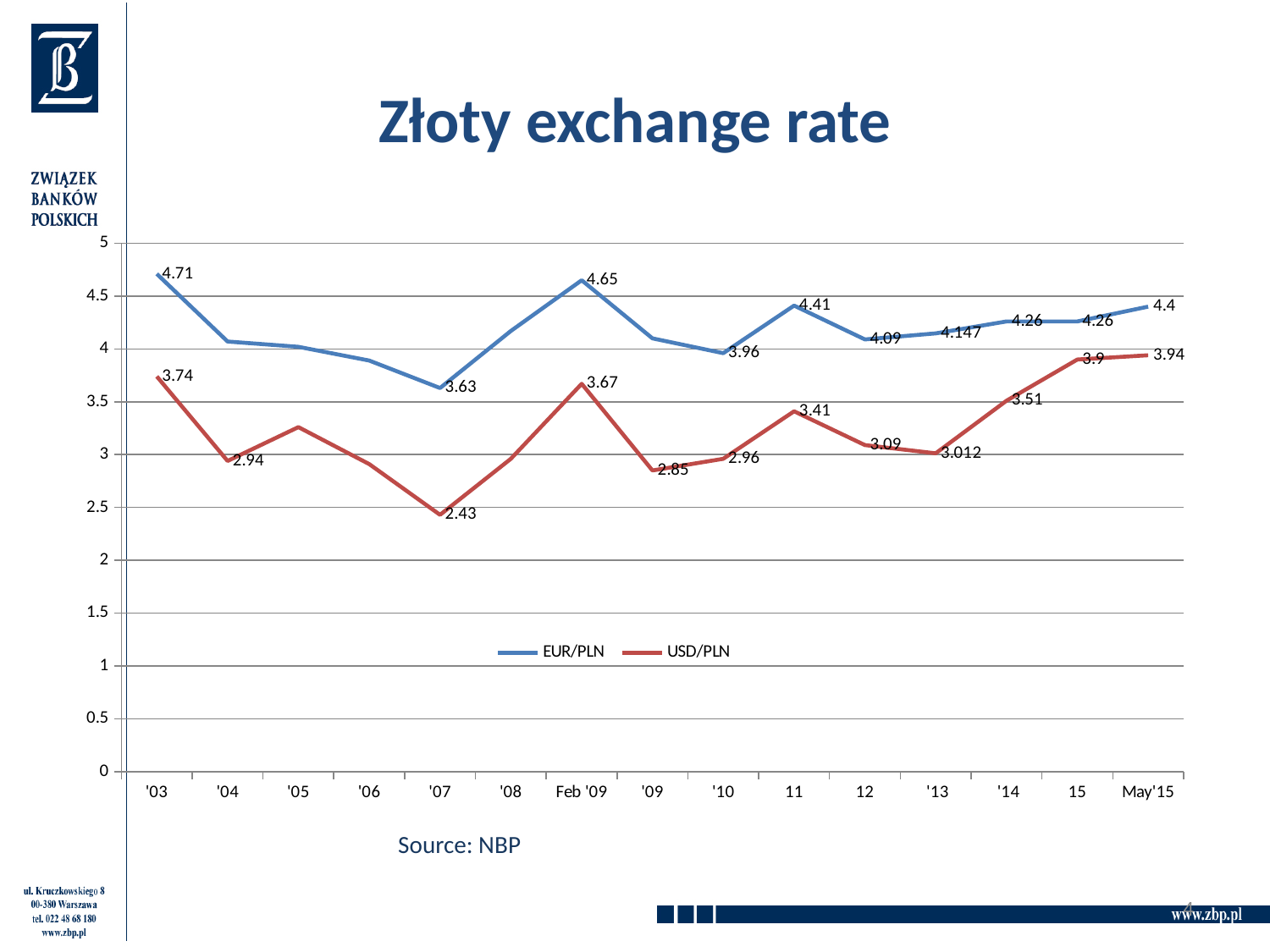
What is the difference between the EUR/PLN and USD/PLN values for Feb '09? 0.98 What is the USD/PLN value for May'15? 3.94 In which period is the EUR/PLN rate highest? '03 What is the EUR/PLN value for '03? 4.71 How many periods are shown on the x axis? 15 In which period is the USD/PLN rate lowest? '07 Which is larger, the EUR/PLN value for 11 or for 12? 11 Is the EUR/PLN value for '04 greater or less than 4? greater Does the USD/PLN rate rise or fall from '13 to May'15? rise What kind of chart is shown on the slide? line chart How many series does the legend list? 2 What is the USD/PLN value for '07? 2.43